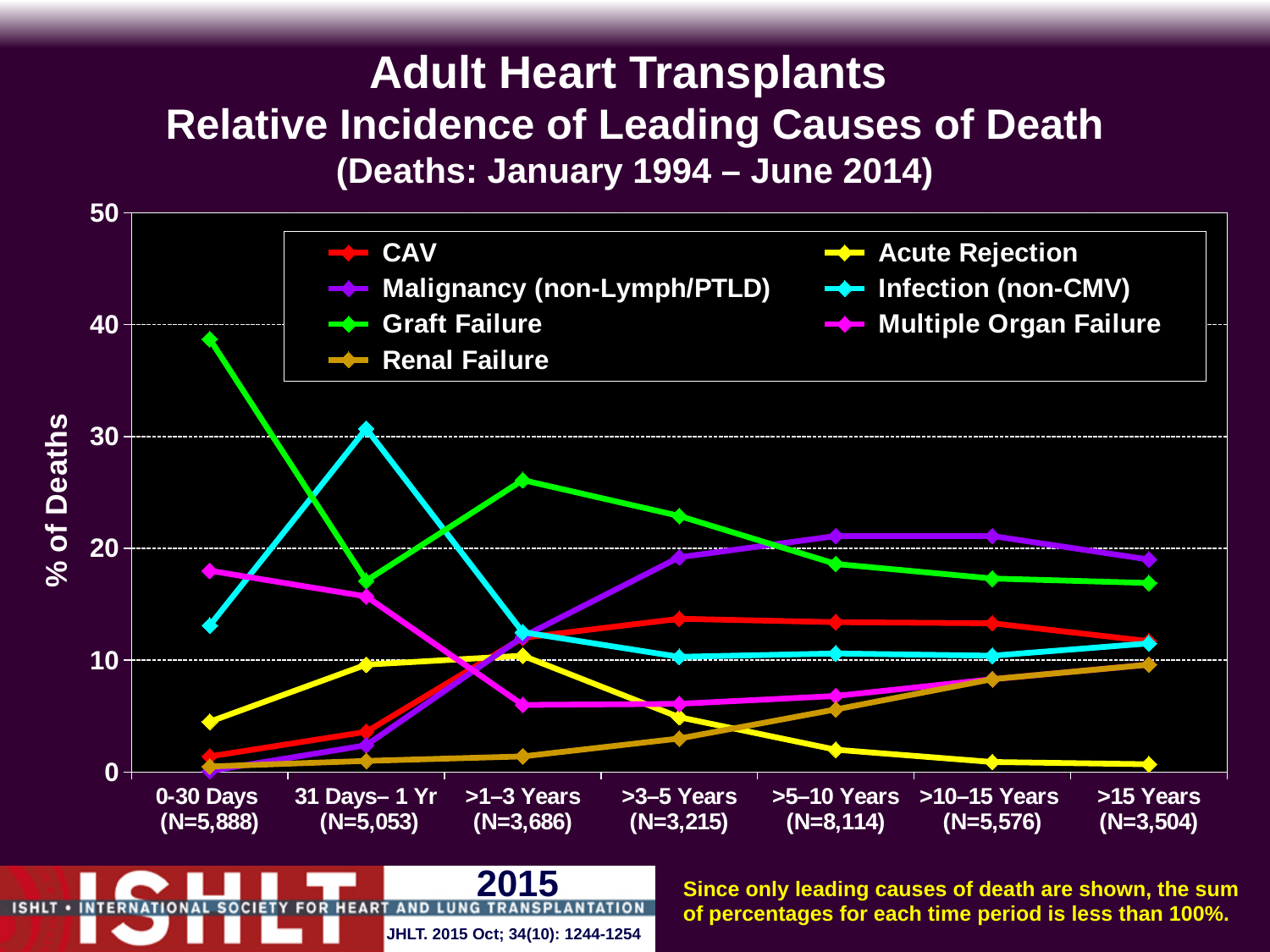
Which cause of death has the highest % of deaths in the 31 Days– 1 Yr period? Infection (non-CMV) At >15 Years, which is larger: Malignancy (non-Lymph/PTLD) or Graft Failure? Malignancy (non-Lymph/PTLD) Does the Renal Failure line rise or fall from 0-30 Days to >15 Years? Rises What kind of chart is shown on the slide? Line chart Is the value for Infection (non-CMV) at 31 Days– 1 Yr greater or less than 20? greater How many time periods are shown along the x axis? 7 Is the value for Graft Failure at 0-30 Days greater or less than 30? greater Is the value for Acute Rejection at >15 Years greater or less than 10? less Which cause of death has the highest % of deaths in the 0-30 Days period? Graft Failure How many series does the legend list? 7 What is the label of the y axis? % of Deaths Which cause of death has the highest % of deaths in the >5–10 Years period? Malignancy (non-Lymph/PTLD)